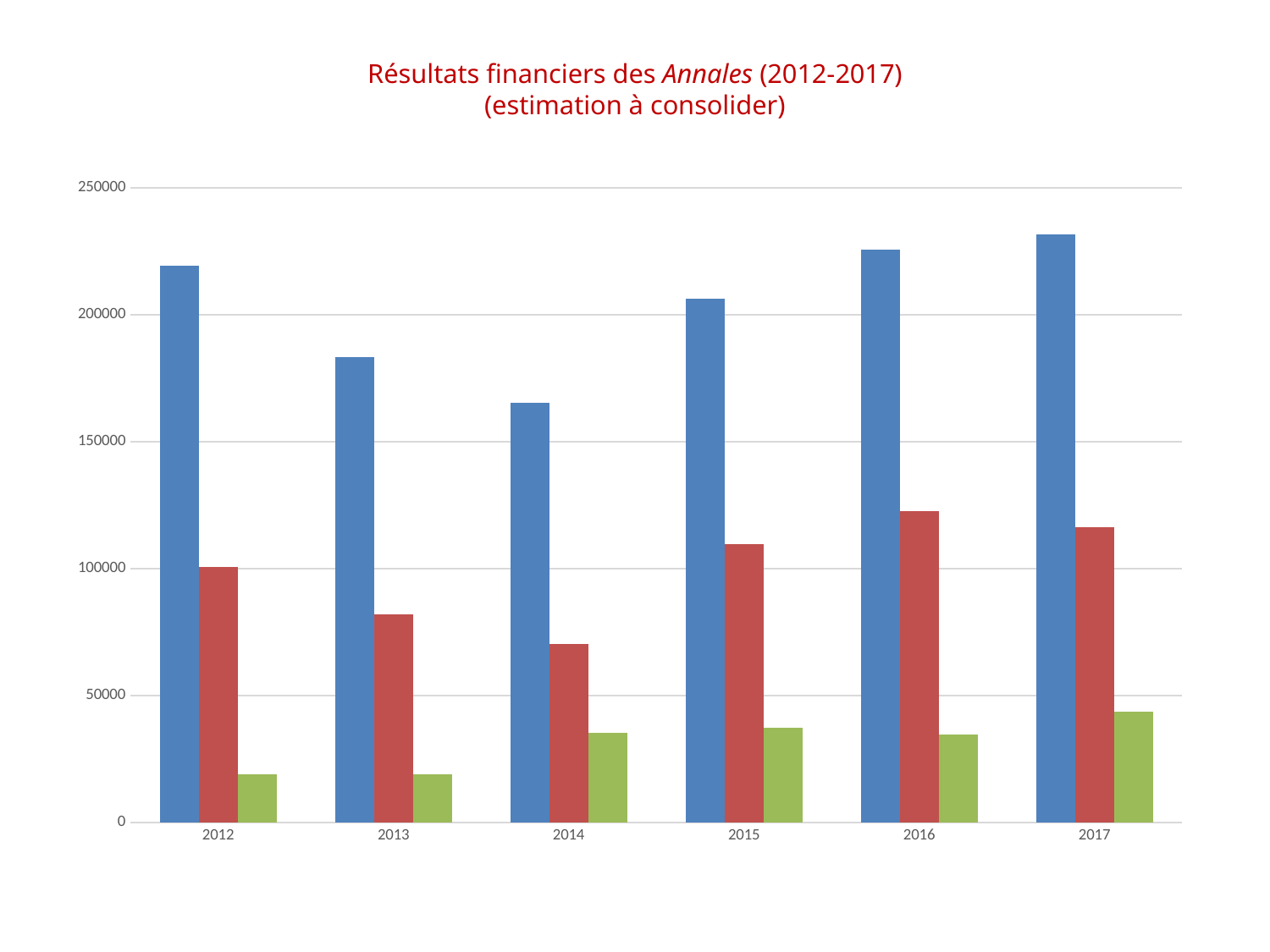
What is the title of the chart? Résultats financiers des Annales (2012-2017) (estimation à consolider) Is the value of the green bar for 2017 greater or less than 50000? less Is the value of the blue bar for 2012 greater or less than 200000? greater Which is larger, the blue bar for 2012 or the blue bar for 2013? 2012 Is the value of the blue bar for 2014 greater or less than 200000? less How many years are shown along the x axis of the chart? 6 How many bars are plotted for each year in the chart? 3 What kind of chart is shown on the slide? bar chart In which year is the red bar the highest? 2016 In which year is the blue bar the lowest? 2014 In which year is the green bar the highest? 2017